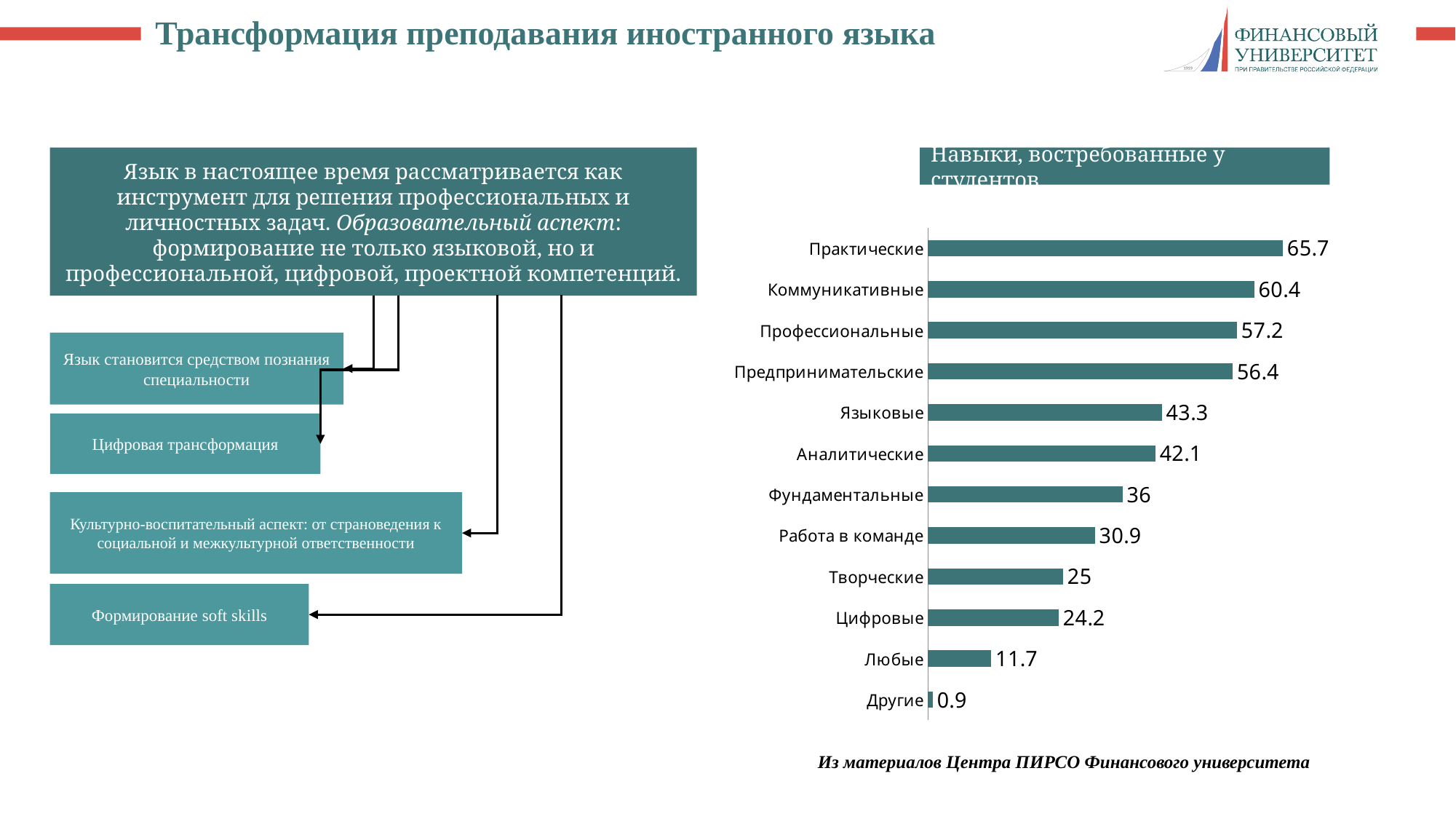
What is the value for Цифровые? 24.2 What is the title of the chart? Навыки, востребованные у студентов How many categories are shown in the chart? 12 What is the difference between the values for Языковые and Аналитические? 1.2 What kind of chart is shown on the slide? Bar chart What is the value for Работа в команде? 30.9 Which is larger, the value for Фундаментальные or the value for Творческие? Фундаментальные Which is larger, the value for Любые or the value for Цифровые? Цифровые What is the difference between the values for Практические and Коммуникативные? 5.3 What is the value for Практические? 65.7 Which category has the lowest value? Другие Which category has the highest value? Практические